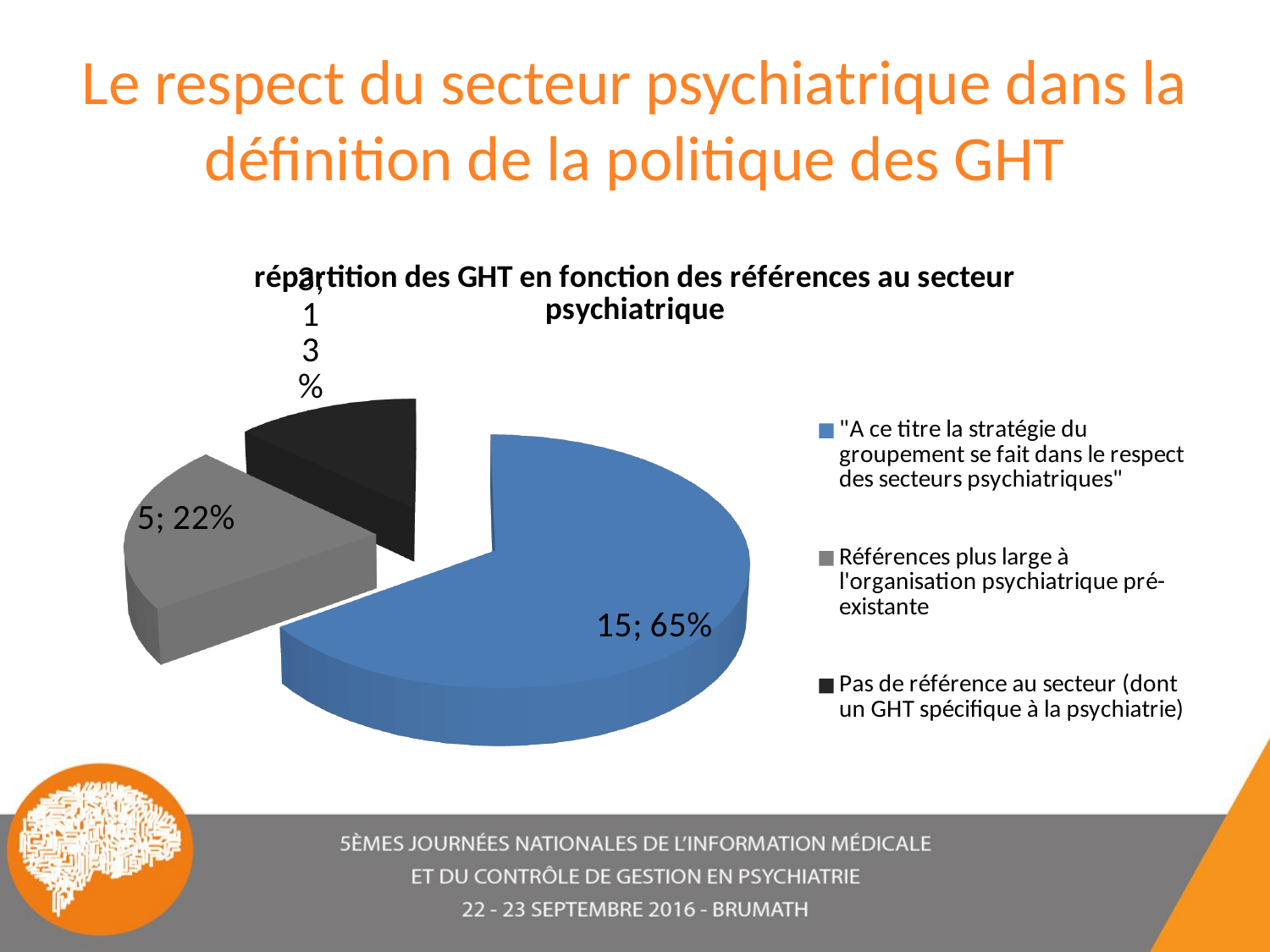
How many slices does the pie chart have? 3 What share of the pie does the category "Références plus large à l'organisation psychiatrique pré-existante" represent? 22% How many entries does the legend list? 3 What is the title of the chart? répartition des GHT en fonction des références au secteur psychiatrique How many GHT are in the category "Références plus large à l'organisation psychiatrique pré-existante"? 5 How many GHT are in the category "A ce titre la stratégie du groupement se fait dans le respect des secteurs psychiatriques"? 15 How many GHT are in the category "Pas de référence au secteur (dont un GHT spécifique à la psychiatrie)"? 3 What kind of chart is shown on the slide? pie chart Which category has the largest slice of the pie? "A ce titre la stratégie du groupement se fait dans le respect des secteurs psychiatriques" What is the difference in number of GHT between the category "A ce titre la stratégie du groupement se fait dans le respect des secteurs psychiatriques" and the category "Références plus large à l'organisation psychiatrique pré-existante"? 10 Which category has the smallest slice of the pie? Pas de référence au secteur (dont un GHT spécifique à la psychiatrie) What share of the pie does the category "A ce titre la stratégie du groupement se fait dans le respect des secteurs psychiatriques" represent? 65%